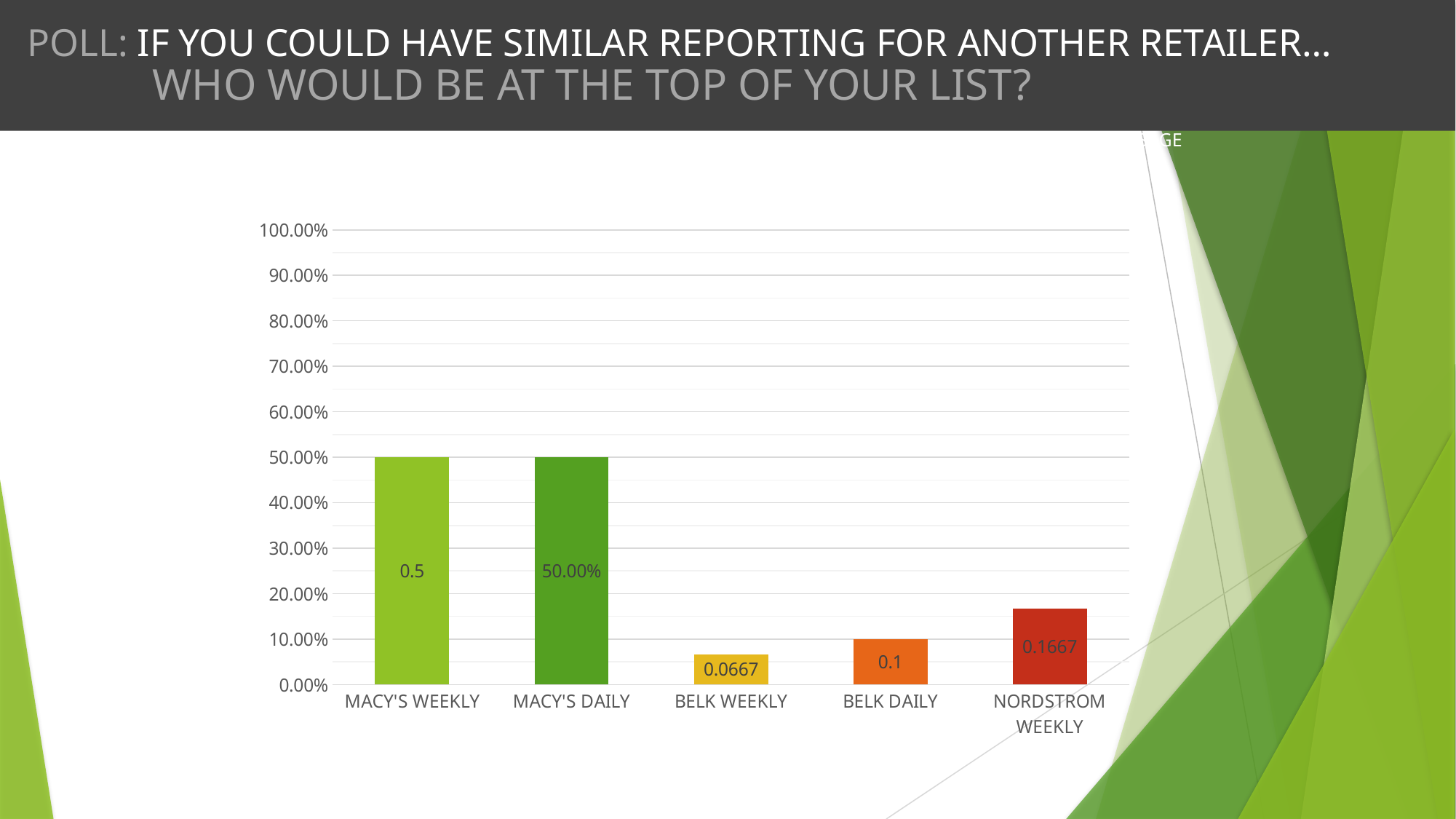
Which is larger, the value for NORDSTROM WEEKLY or the value for BELK DAILY? NORDSTROM WEEKLY What kind of chart is shown on the slide? bar chart What colour is the bar for NORDSTROM WEEKLY? red What is the data label shown on the bar for MACY'S WEEKLY? 0.5 Is the value for MACY'S WEEKLY greater or less than 40.00%? greater Which category has the lowest value in the chart? BELK WEEKLY How many categories are shown on the x axis of the chart? 5 What is the data label shown on the bar for NORDSTROM WEEKLY? 0.1667 What is the data label shown on the bar for BELK WEEKLY? 0.0667 Is the value for NORDSTROM WEEKLY greater or less than 20.00%? less What is the data label shown on the bar for MACY'S DAILY? 50.00% What is the data label shown on the bar for BELK DAILY? 0.1